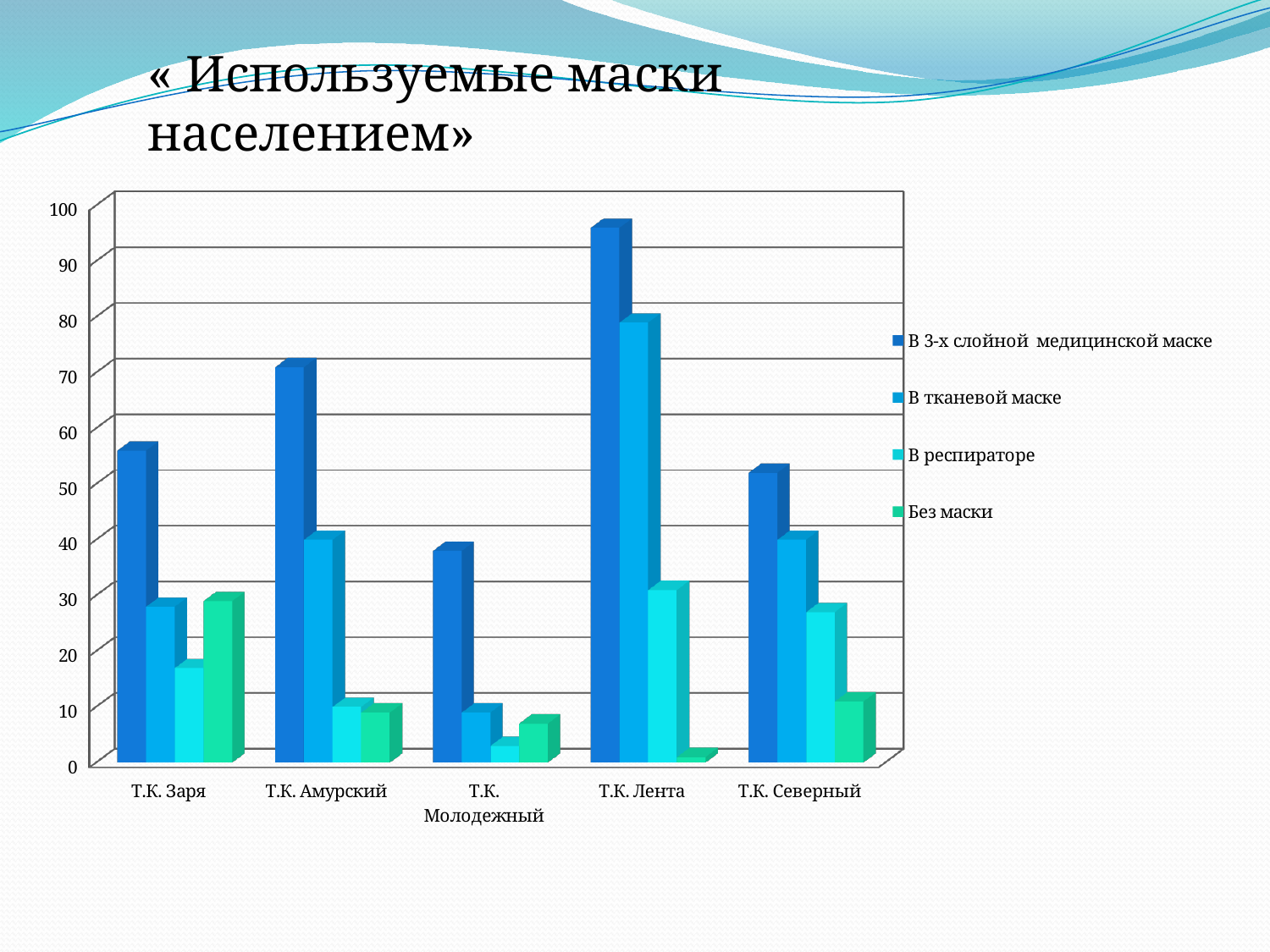
Is the value for 'В респираторе' at Т.К. Молодежный greater or less than 10? less Which category has the highest value for 'В 3-х слойной медицинской маске'? Т.К. Лента Is the value for 'В 3-х слойной медицинской маске' at Т.К. Лента greater or less than 90? greater How many categories (shopping centres) are shown on the x axis? 5 Which category has the lowest value for 'Без маски'? Т.К. Лента Is the value for 'В тканевой маске' at Т.К. Амурский greater or less than 50? less Which is larger: the 'В тканевой маске' value at Т.К. Лента or at Т.К. Северный? Т.К. Лента How many series does the legend list? 4 Which category has the lowest value for 'В 3-х слойной медицинской маске'? Т.К. Молодежный What kind of chart is shown on the slide? bar chart What is the title of the slide containing the chart? « Используемые маски населением» Which category has the highest value for 'Без маски'? Т.К. Заря